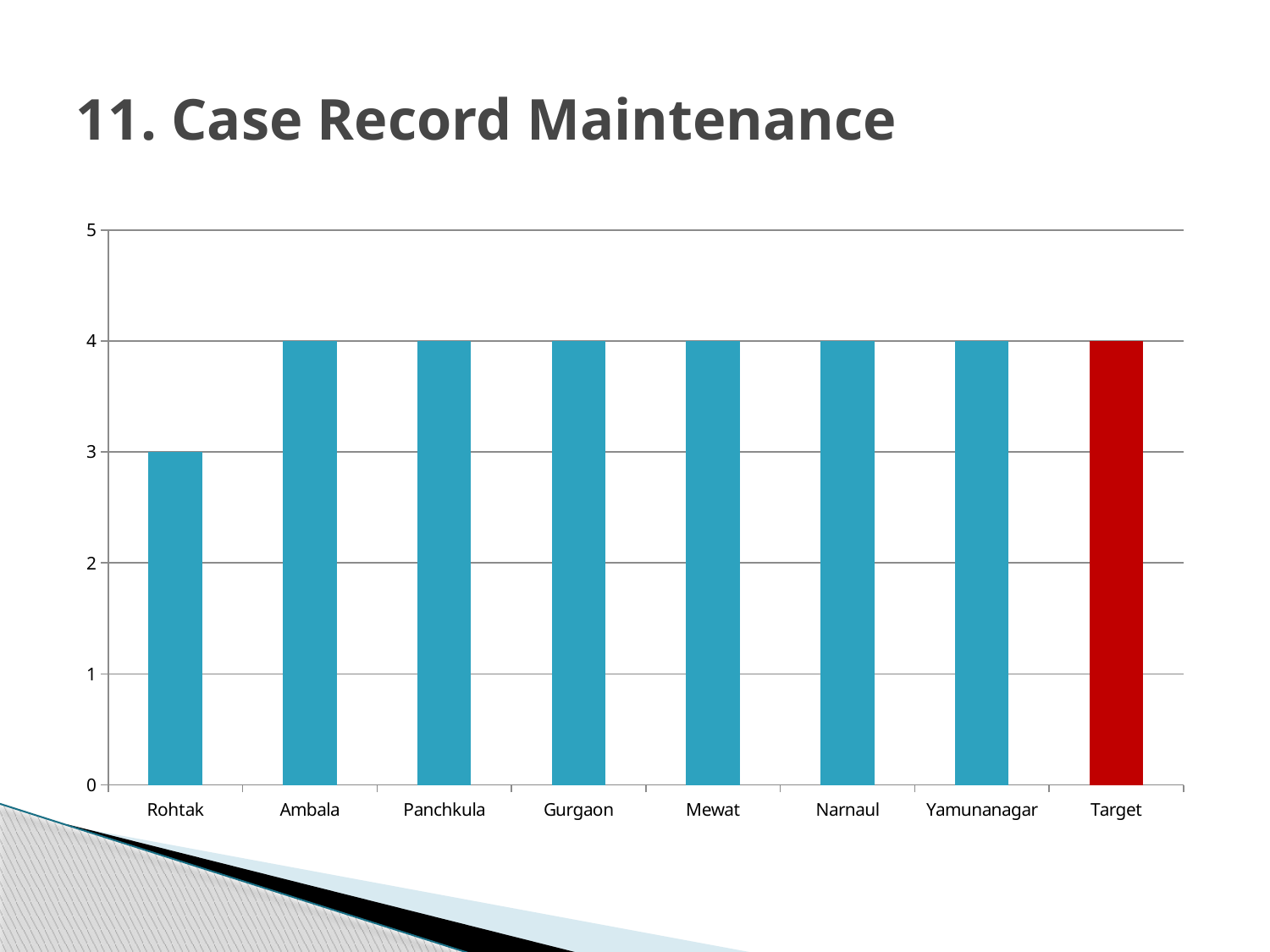
What is the value of the Target bar? 4 How many categories have a value of 4? 7 How many categories are shown on the x axis? 8 Which is larger, the value for Rohtak or the value for Gurgaon? Gurgaon What is the difference between the Target value and the Rohtak value? 1 What is the value for Ambala? 4 What is the title of the slide? 11. Case Record Maintenance What kind of chart is shown on the slide? bar chart What is the value for Rohtak? 3 Is the value for Mewat greater or less than 3? greater Which category has the lowest value? Rohtak Which bar is coloured red? Target